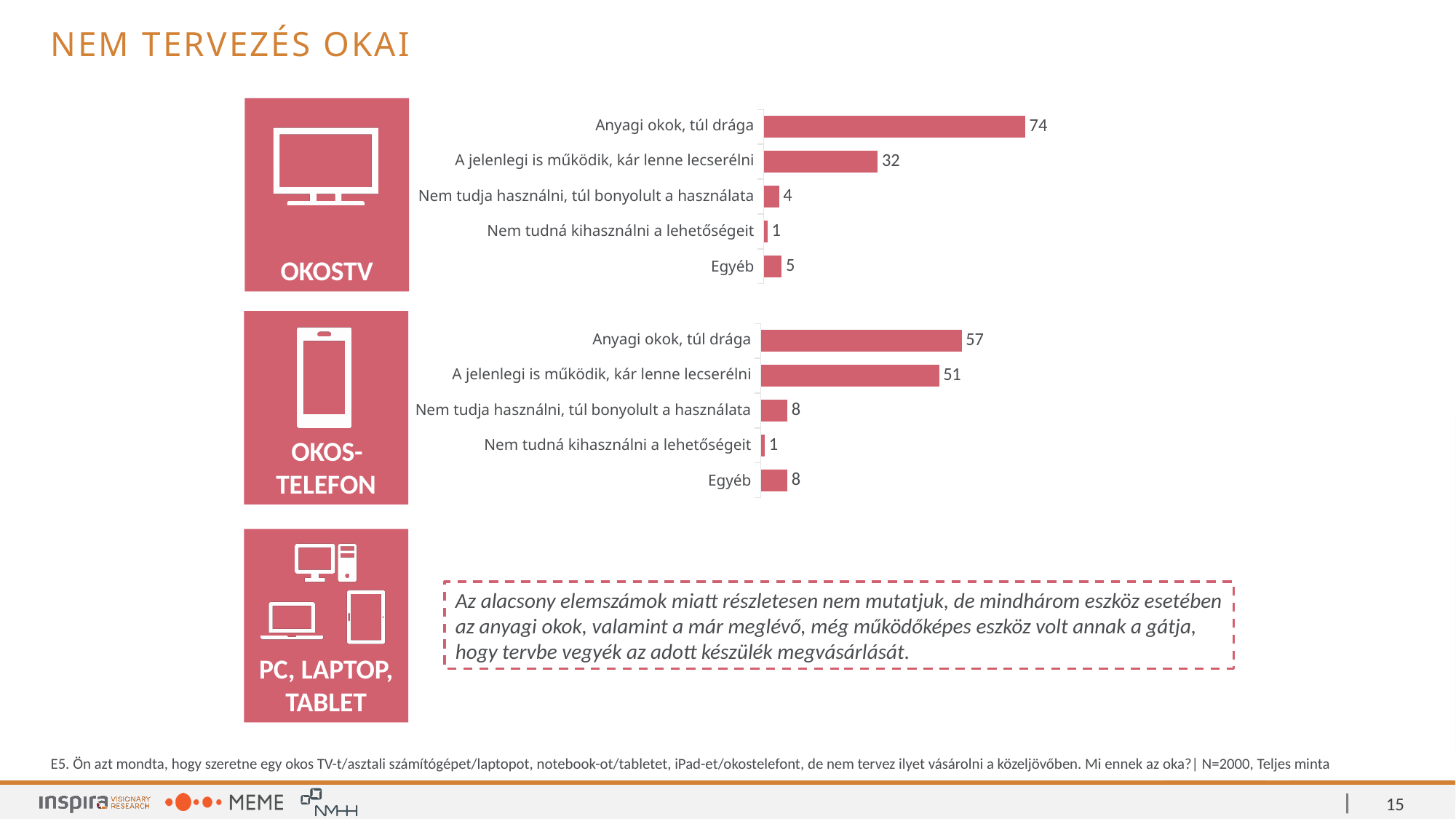
What type of chart is the OKOS-TELEFON chart? Bar chart In the OKOS-TELEFON chart, which category has the lowest value? Nem tudná kihasználni a lehetőségeit In the OKOSTV chart, what is the value for "Anyagi okok, túl drága"? 74 In the OKOSTV chart, what is the value for "A jelenlegi is működik, kár lenne lecserélni"? 32 In the OKOSTV chart, which category has the highest value? Anyagi okok, túl drága In the OKOS-TELEFON chart, what is the value for "A jelenlegi is működik, kár lenne lecserélni"? 51 What is the title of the slide? NEM TERVEZÉS OKAI In the OKOSTV chart, what is the difference between "Anyagi okok, túl drága" and "A jelenlegi is működik, kár lenne lecserélni"? 42 In the OKOS-TELEFON chart, what is the difference between "Anyagi okok, túl drága" and "A jelenlegi is működik, kár lenne lecserélni"? 6 In the OKOS-TELEFON chart, what is the value for "Nem tudja használni, túl bonyolult a használata"? 8 How many categories does the OKOSTV chart show? 5 Which is larger: the value for "Egyéb" in the OKOSTV chart or in the OKOS-TELEFON chart? OKOS-TELEFON